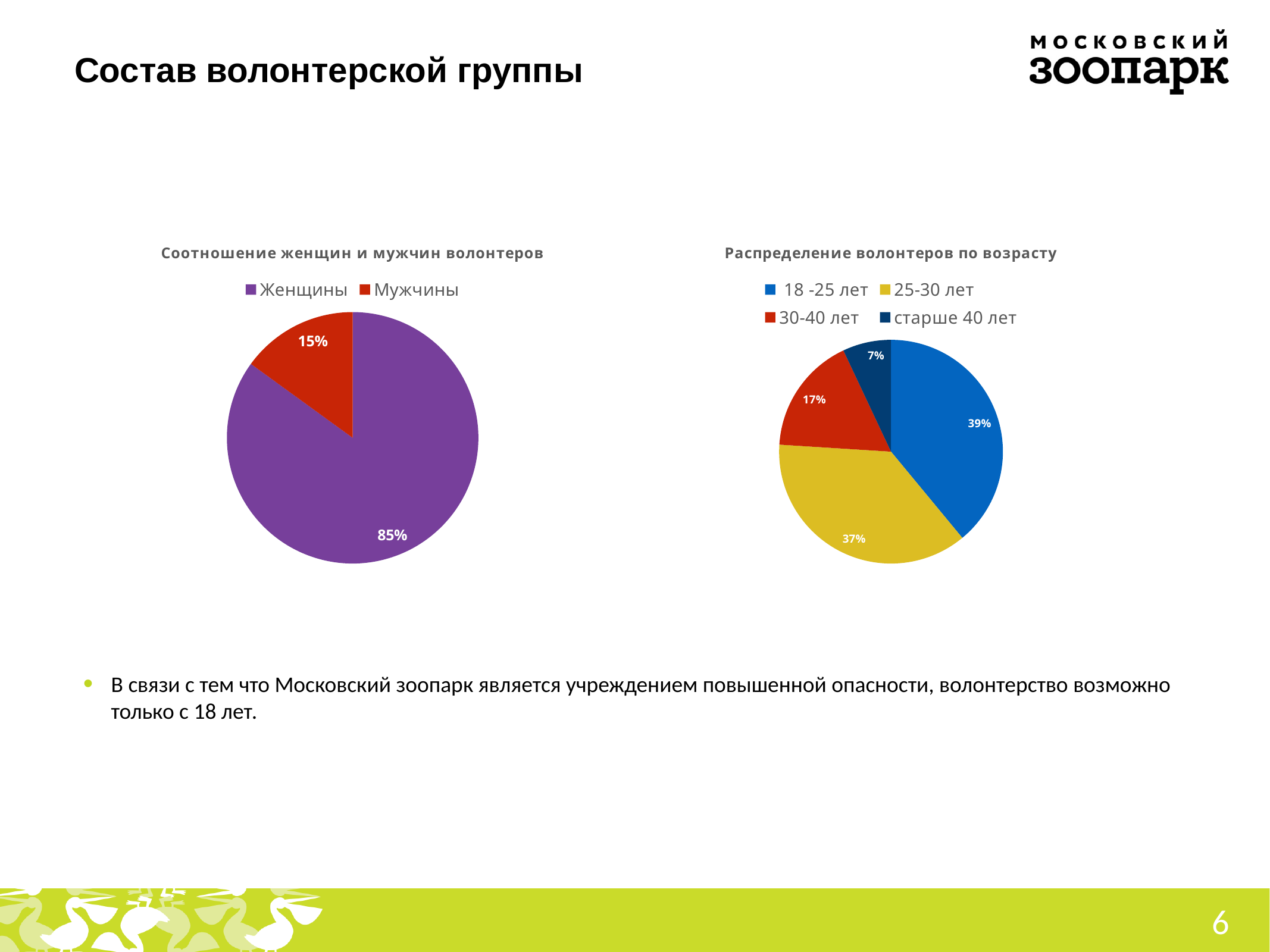
In the chart titled "Соотношение женщин и мужчин волонтеров", what share of volunteers are Женщины? 85% In the chart titled "Соотношение женщин и мужчин волонтеров", what kind of chart is shown? Pie chart In the chart titled "Распределение волонтеров по возрасту", which age group has the smallest share? старше 40 лет In the chart titled "Распределение волонтеров по возрасту", which age group has the largest share? 18 -25 лет In the chart titled "Распределение волонтеров по возрасту", what share of volunteers are aged 18 -25 лет? 39% In the chart titled "Распределение волонтеров по возрасту", what share of volunteers are aged 25-30 лет? 37% In the chart titled "Соотношение женщин и мужчин волонтеров", what share of volunteers are Мужчины? 15% In the chart titled "Распределение волонтеров по возрасту", what is the difference between the 30-40 лет and старше 40 лет shares? 10% In the chart titled "Распределение волонтеров по возрасту", what share of volunteers are aged старше 40 лет? 7% In the chart titled "Соотношение женщин и мужчин волонтеров", how many slices does the pie have? 2 In the chart titled "Соотношение женщин и мужчин волонтеров", what is the difference between the Женщины and Мужчины shares? 70% In the chart titled "Распределение волонтеров по возрасту", how many age groups does the legend list? 4